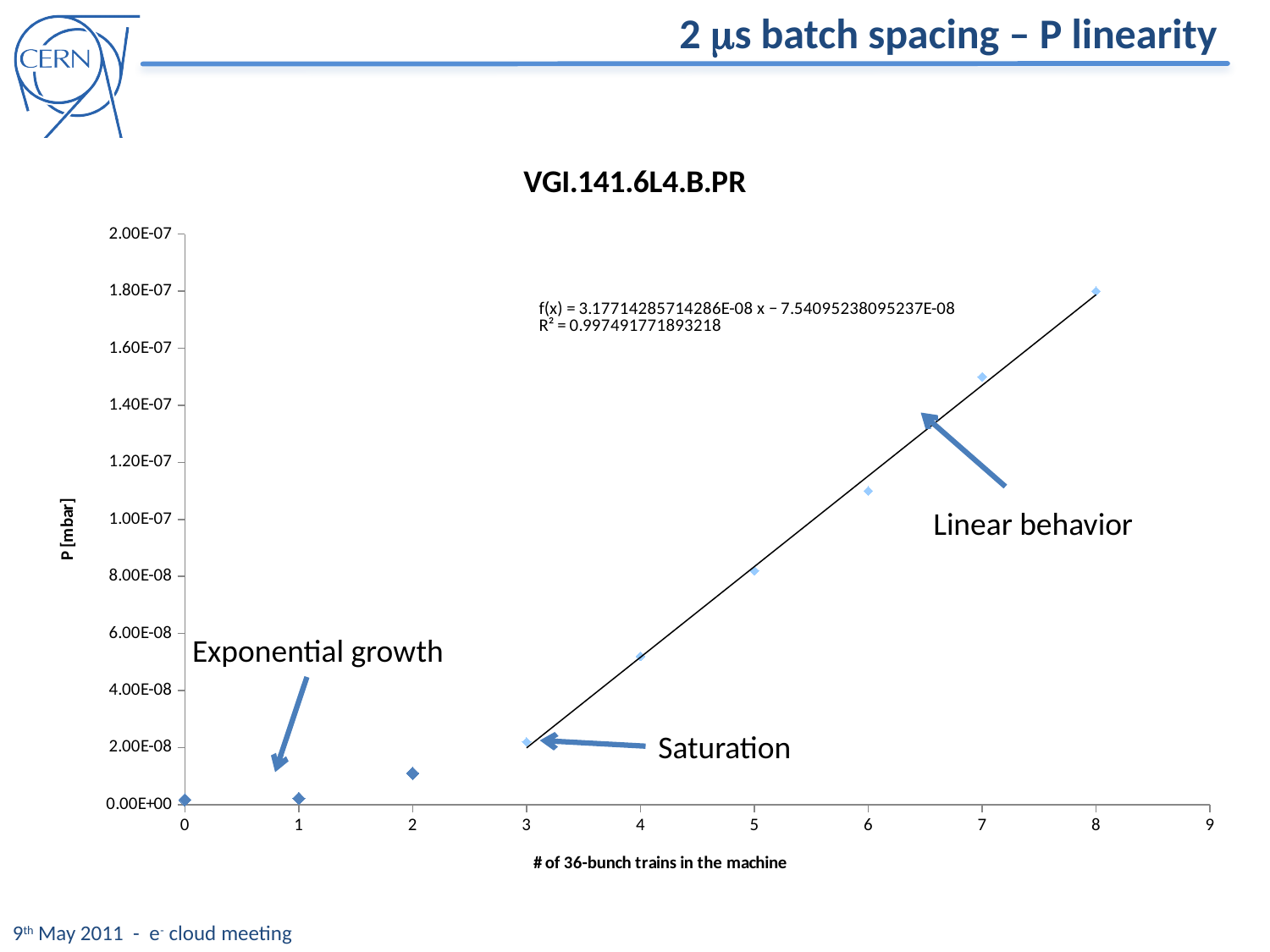
How many data points are plotted on the chart? 9 Is the value of P for 4 trains greater or less than 6.00E-08? less Is the value of P for 6 trains greater or less than 1.00E-07? greater At which number of 36-bunch trains is the pressure P highest? 8 What kind of chart is shown on the slide? scatter chart What is the title of the chart? VGI.141.6L4.B.PR Is the value of P for 2 trains greater or less than 2.00E-08? less What R² value is printed for the linear fit on the chart? 0.997491771893218 Does the pressure P rise or fall as the number of 36-bunch trains increases? rise Which has a larger value of P: 7 trains or 4 trains? 7 trains At which number of 36-bunch trains is the pressure P lowest? 0